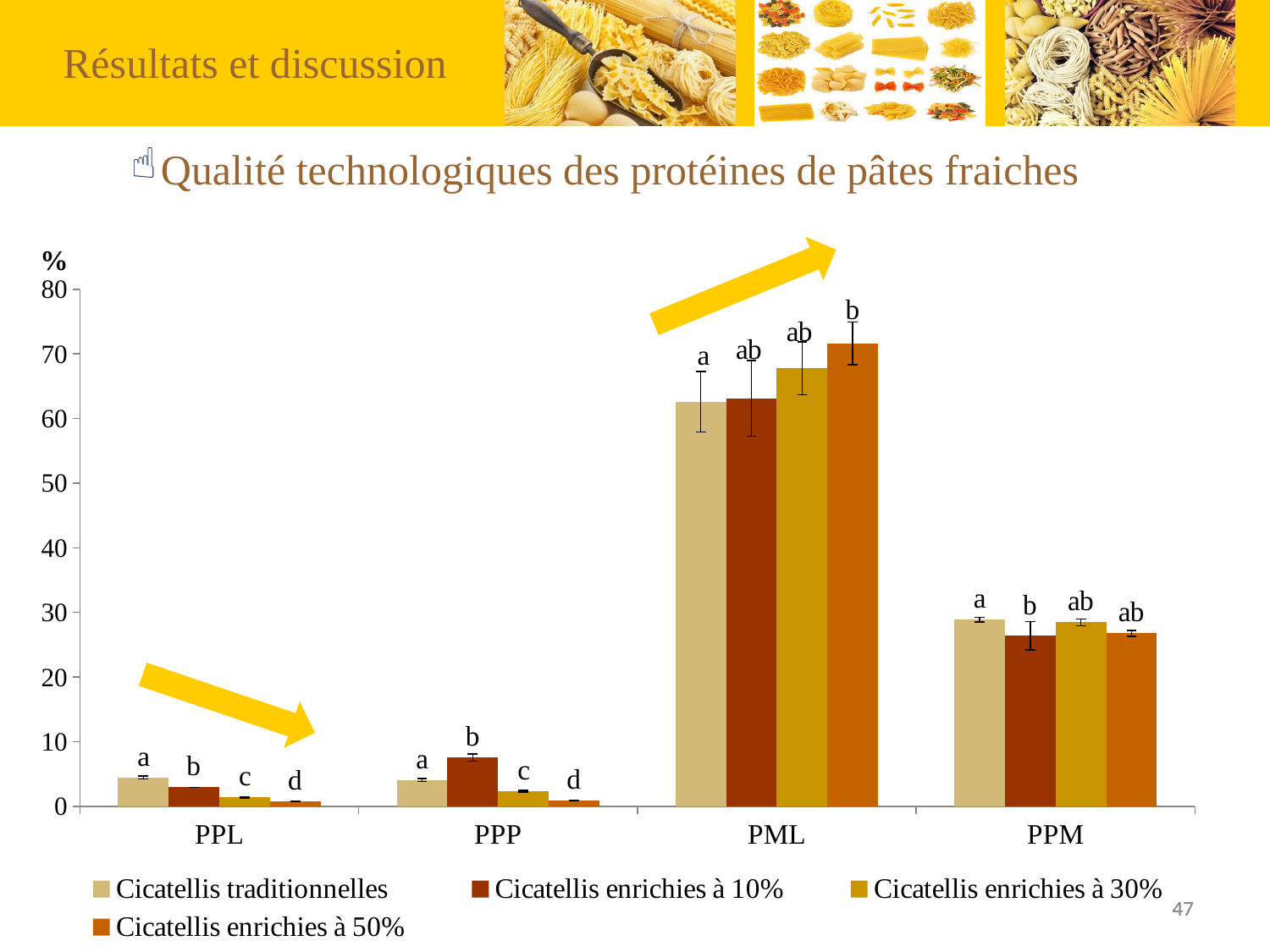
How many categories are shown on the x axis of the chart? 4 Which category has the highest bars in the chart? PML In the PML category, do the values rise or fall going from Cicatellis traditionnelles to Cicatellis enrichies à 50%? rise In the PPP category, which is larger: Cicatellis enrichies à 10% or Cicatellis traditionnelles? Cicatellis enrichies à 10% Is the value for Cicatellis traditionnelles in the PML category greater or less than 60? greater In the PML category, which is larger: Cicatellis enrichies à 50% or Cicatellis traditionnelles? Cicatellis enrichies à 50% In the PPL category, which series has the lowest bar? Cicatellis enrichies à 50% Is the value for Cicatellis traditionnelles in the PPM category greater or less than 20? greater What unit is shown at the top of the y axis of the chart? % Is the value for Cicatellis enrichies à 50% in the PML category greater or less than 70? greater What kind of chart is shown on the slide? bar chart How many series does the chart legend list? 4